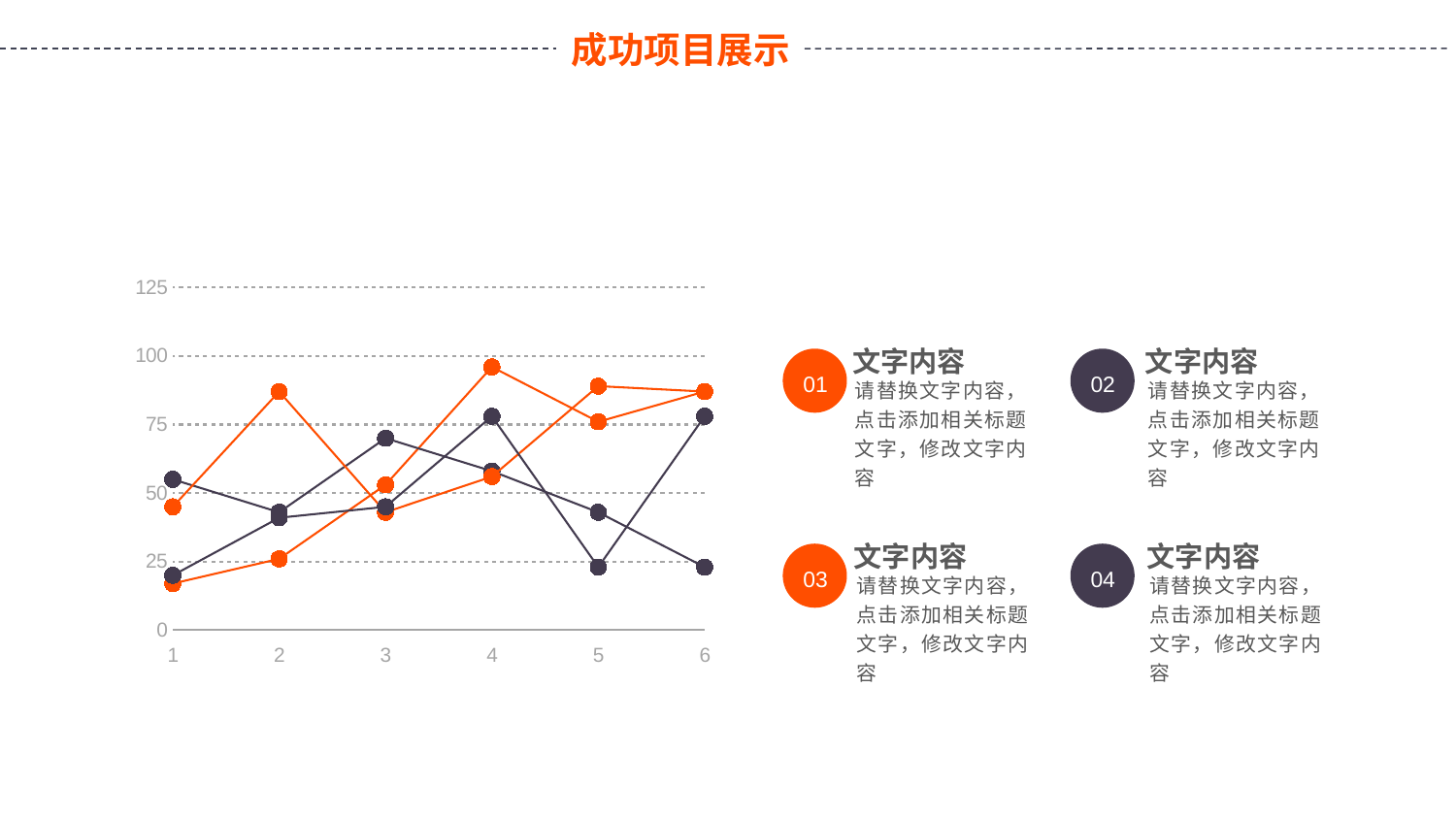
Is the highest value plotted at x = 2 greater or less than 75? greater What two colours are used for the lines on the chart? orange and dark purple Is the highest value plotted at x = 4 greater or less than 75? greater How many points are labelled along the x axis of the chart? 6 How many lines are plotted on the chart? 4 At which x-axis value does the highest point on the chart occur? 4 What is the highest tick value shown on the y axis? 125 What is the title shown at the top of the slide? 成功项目展示 Is the lowest value plotted at x = 1 greater or less than 25? less What kind of chart is shown on the slide? line chart